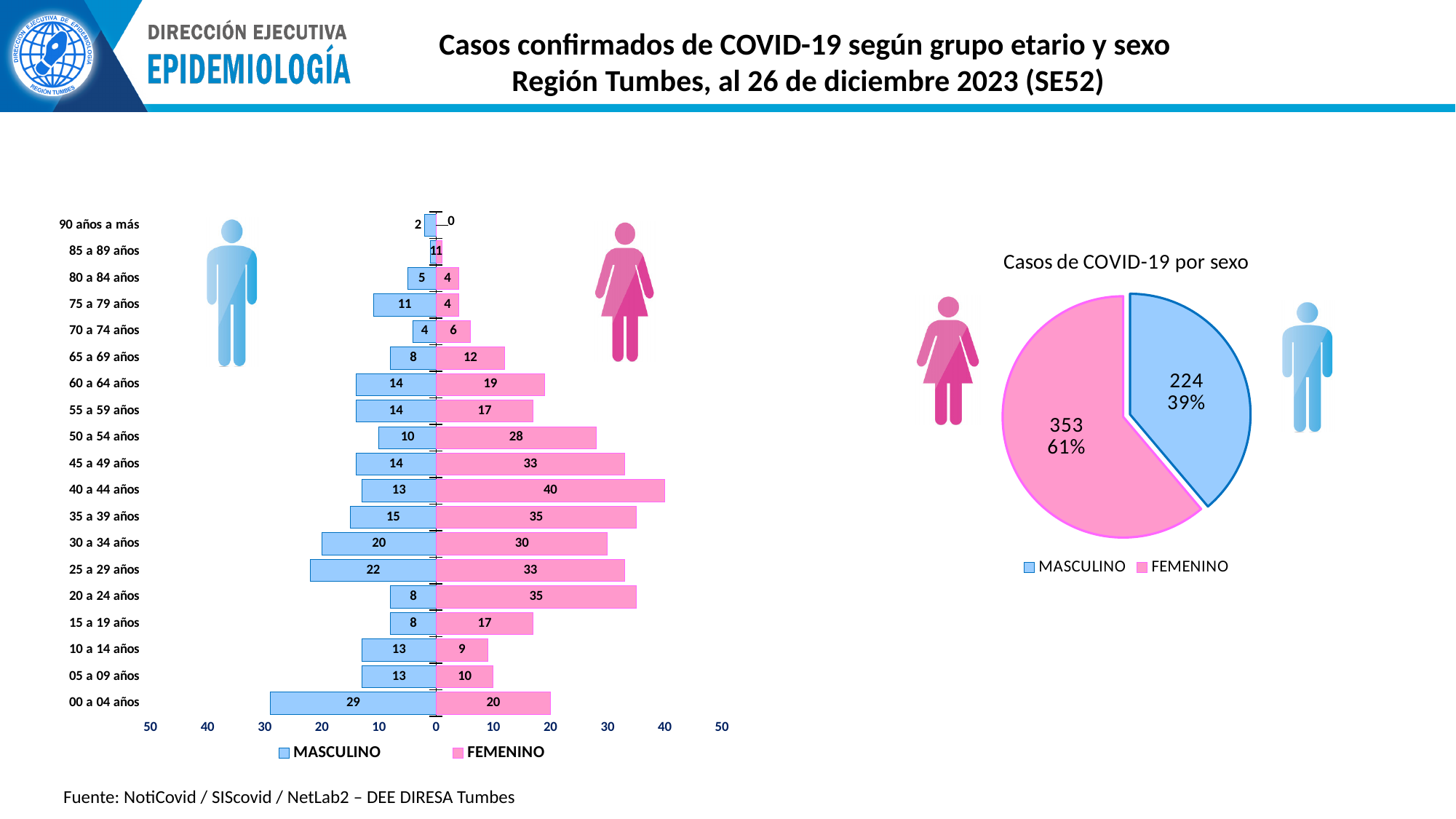
In the population pyramid chart on the left, how many series does the legend list? 2 In the population pyramid chart on the left, which age group has the highest MASCULINO value? 00 a 04 años In the 'Casos de COVID-19 por sexo' pie chart, what share of cases is FEMENINO? 61% In the population pyramid chart on the left, what is the difference between the FEMENINO and MASCULINO values for the 20 a 24 años age group? 27 In the population pyramid chart on the left, which is larger for the 75 a 79 años age group, MASCULINO or FEMENINO? MASCULINO In the population pyramid chart on the left, what is the FEMENINO value for the 40 a 44 años age group? 40 What kind of chart is the chart on the left of the slide? Bar chart In the 'Casos de COVID-19 por sexo' pie chart, what is the number of MASCULINO cases? 224 In the population pyramid chart on the left, which age group has the highest FEMENINO value? 40 a 44 años What is the title of the pie chart on the right of the slide? Casos de COVID-19 por sexo In the population pyramid chart on the left, what is the MASCULINO value for the 00 a 04 años age group? 29 In the population pyramid chart on the left, how many age groups are shown? 19